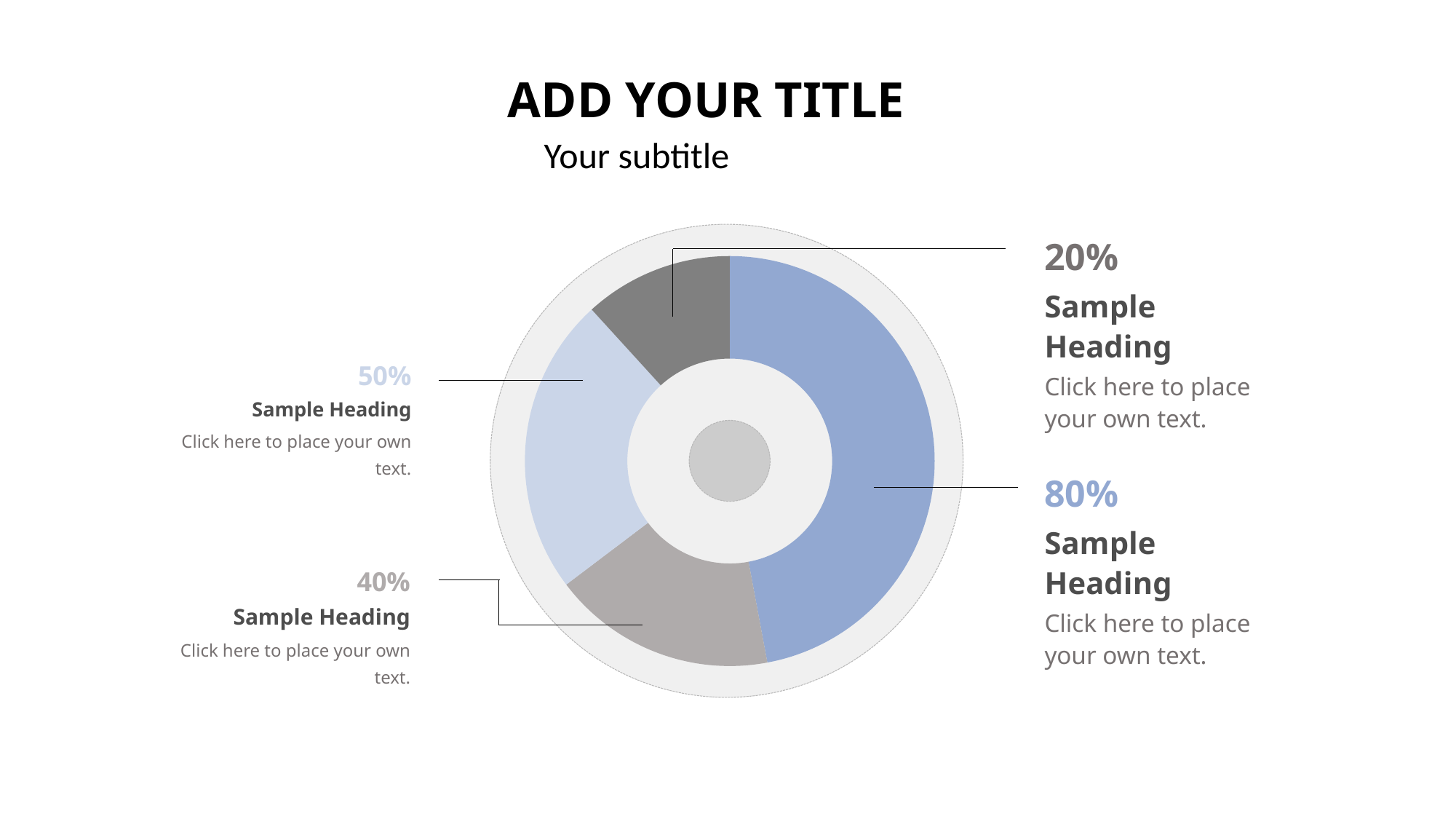
What percentage is labelled on the grey segment at the bottom of the donut chart? 40% Which segment of the donut chart has the lowest labelled percentage? The dark grey segment (20%) Which is larger: the percentage labelled on the light blue segment or the percentage labelled on the bottom grey segment? The light blue segment (50%) What percentage is labelled on the dark grey segment at the top of the donut chart? 20% Which segment of the donut chart has the highest labelled percentage? The blue segment (80%) What is the title shown above the chart on the slide? ADD YOUR TITLE What is the difference between the highest labelled percentage (80%) and the lowest (20%) on the donut chart? 60 percentage points What percentage is labelled on the light blue segment on the left of the donut chart? 50% What kind of chart is shown on the slide? Pie (donut) chart What percentage is labelled on the large blue segment on the right of the donut chart? 80% What heading text is shown next to each percentage label on the slide? Sample Heading How many segments does the donut chart have? 4